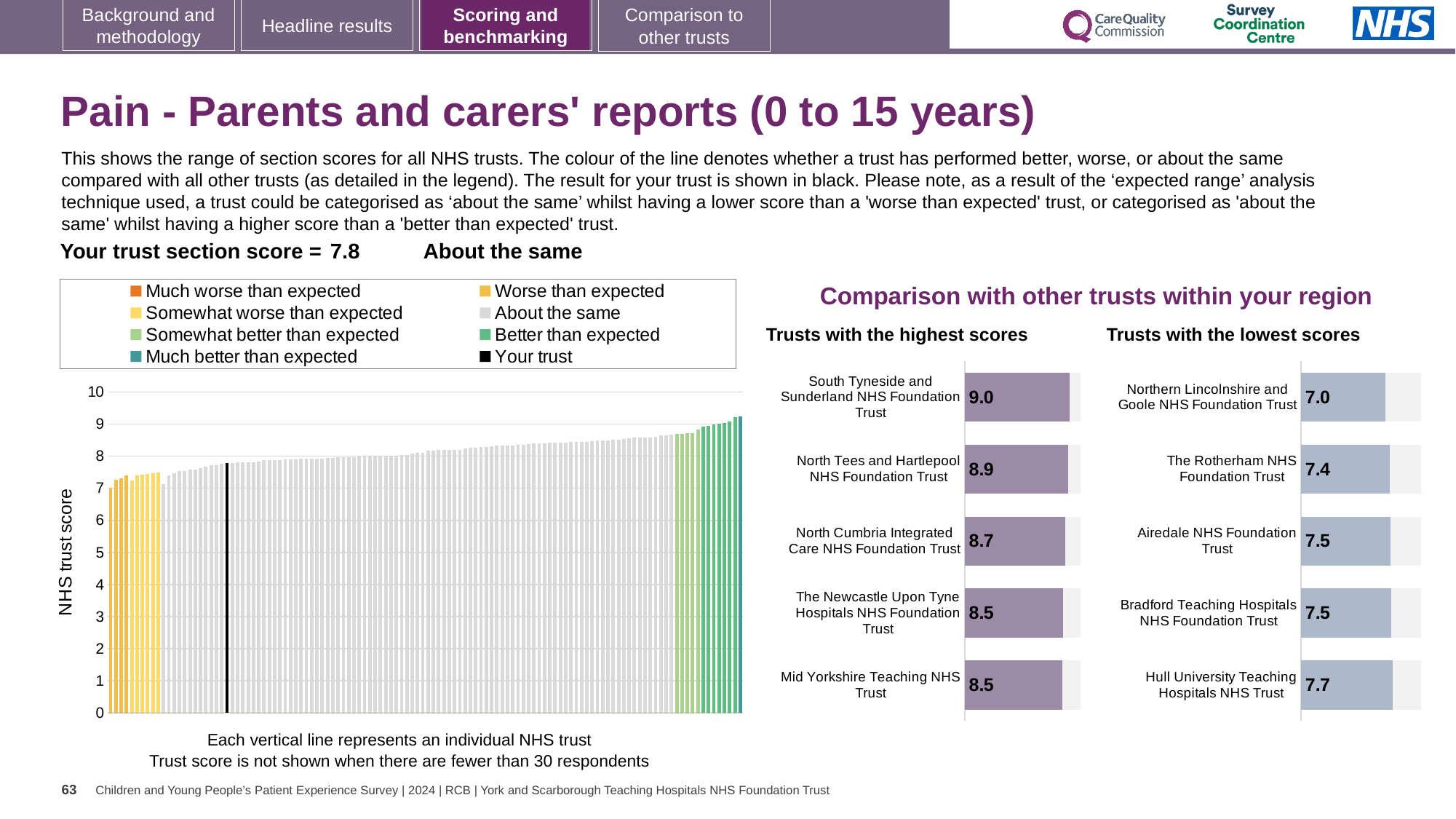
In the large 'NHS trust score' chart on the left, do the values rise or fall from left to right? rise In the 'Trusts with the highest scores' chart, what is the score for North Tees and Hartlepool NHS Foundation Trust? 8.9 In the 'Trusts with the lowest scores' chart, which has the higher score: The Rotherham NHS Foundation Trust or Hull University Teaching Hospitals NHS Trust? Hull University Teaching Hospitals NHS Trust In the 'Trusts with the lowest scores' chart, which trust has the lowest score? Northern Lincolnshire and Goole NHS Foundation Trust How many entries does the legend above the large 'NHS trust score' chart list? 8 In the 'Trusts with the lowest scores' chart, what is the score for Airedale NHS Foundation Trust? 7.5 How many trusts are shown in the 'Trusts with the highest scores' chart? 5 In the 'Trusts with the lowest scores' chart, what is the difference between the scores of Hull University Teaching Hospitals NHS Trust and Northern Lincolnshire and Goole NHS Foundation Trust? 0.7 In the 'Trusts with the highest scores' chart, which trust has the highest score? South Tyneside and Sunderland NHS Foundation Trust What kind of chart is the large 'NHS trust score' chart on the left of the slide? bar chart In the 'Trusts with the highest scores' chart, what is the difference between the scores of South Tyneside and Sunderland NHS Foundation Trust and North Cumbria Integrated Care NHS Foundation Trust? 0.3 In the large 'NHS trust score' chart on the left, what is the section score for your trust (the black bar)? 7.8